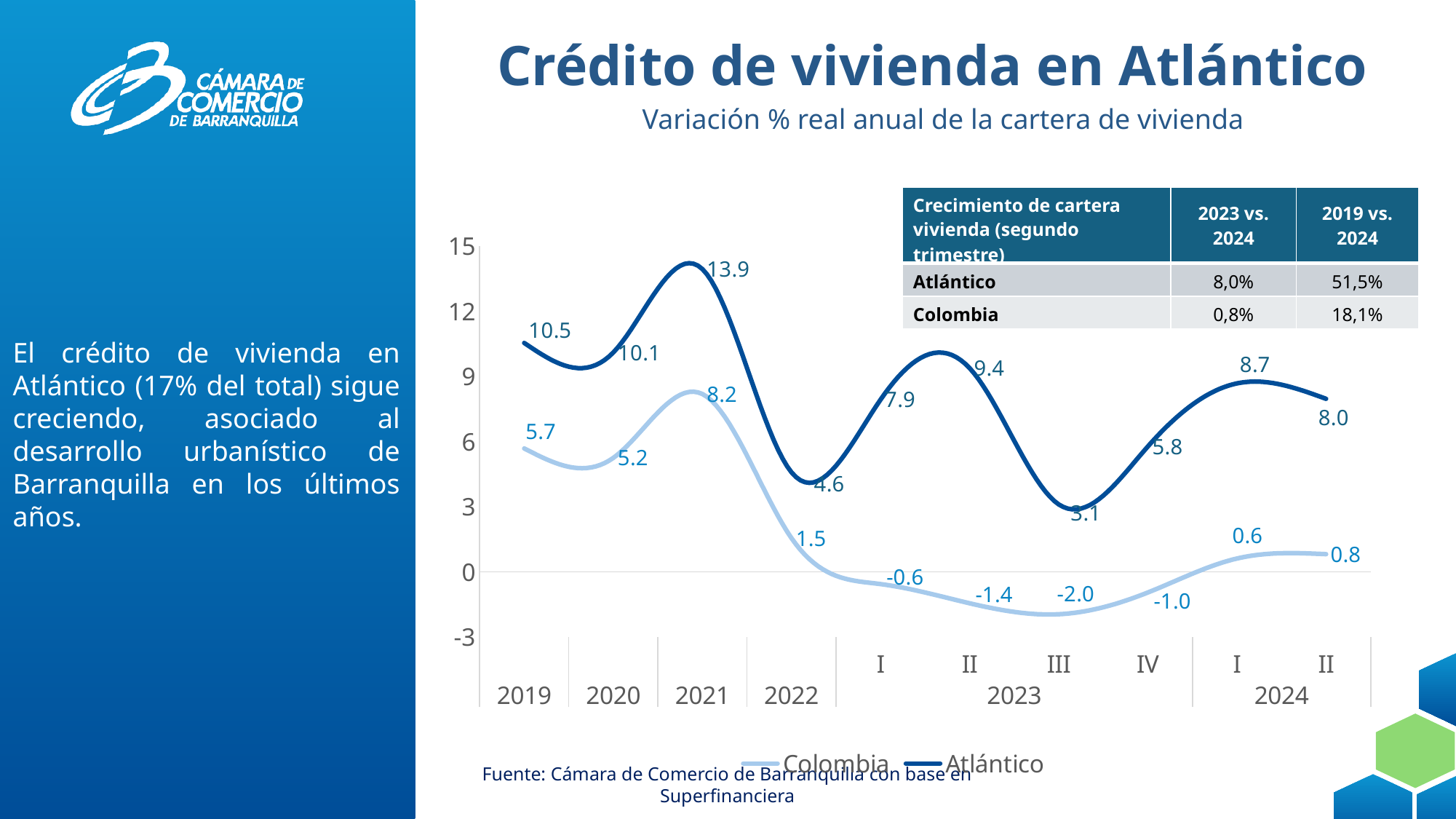
What is the value for Colombia in the second quarter (II) of 2024? 0.8 In which period does the Atlántico series reach its highest value? 2021 How many series does the chart legend list? 2 Does the Colombia series rise or fall from 2021 to 2022? fall Which series has the higher value in the first quarter (I) of 2024, Colombia or Atlántico? Atlántico What is the value for Atlántico in 2021? 13.9 How many data points are plotted for each series along the x axis? 10 In which period does the Colombia series reach its lowest value? III 2023 What is the difference between the Atlántico and Colombia values in 2021? 5.7 What is the value for Atlántico in the third quarter (III) of 2023? 3.1 What is the value for Colombia in 2019? 5.7 What type of chart is shown on the slide? line chart